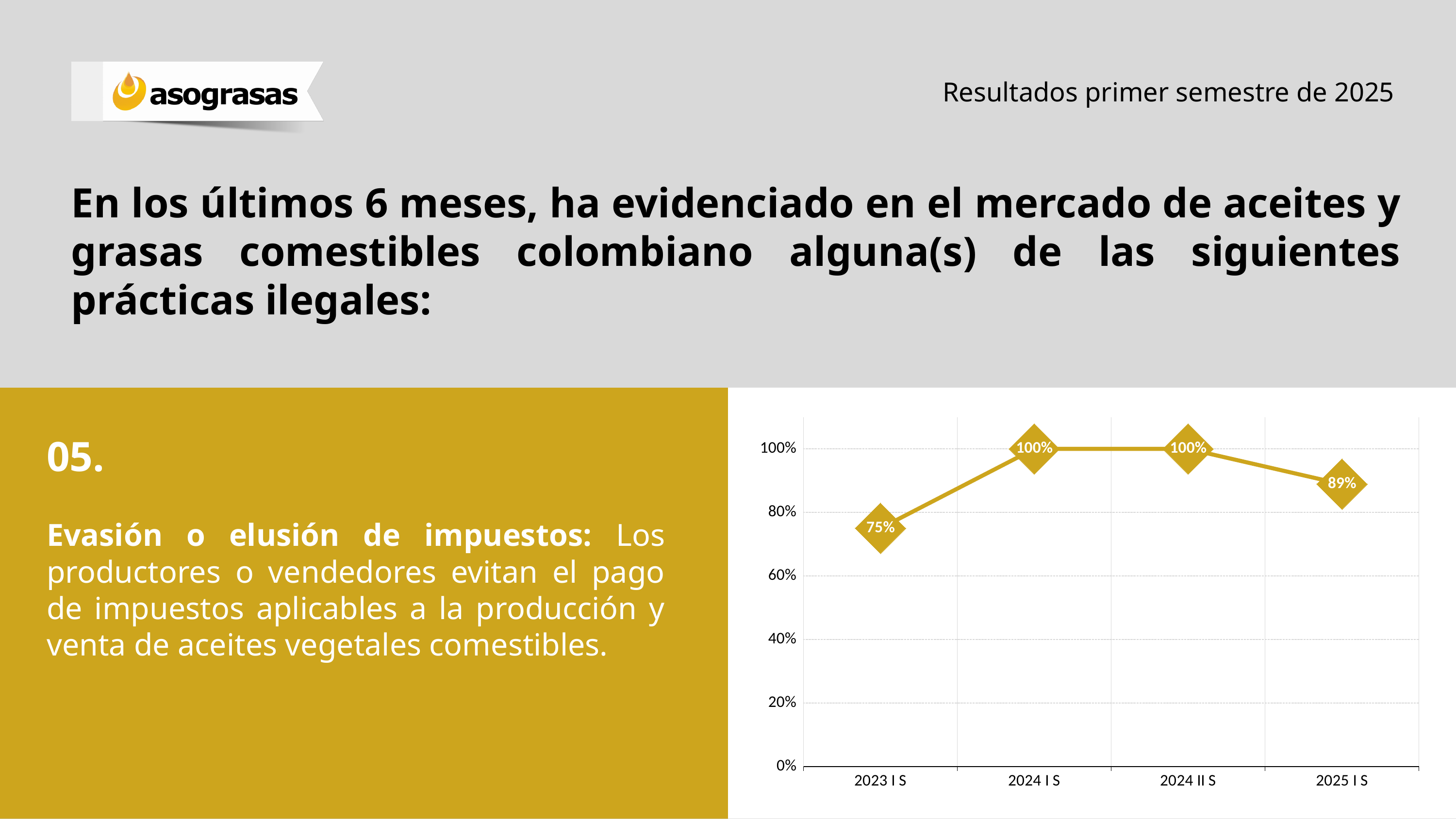
How many periods are plotted on the x axis? 4 What is the difference between the values for 2024 I S and 2023 I S? 25% Does the value rise or fall from 2024 II S to 2025 I S? fall What shape are the data point markers on the line? diamonds What is the value for 2024 II S? 100% Which period has the lowest value? 2023 I S What is the difference between the values for 2024 II S and 2025 I S? 11% Which is larger, the value for 2025 I S or the value for 2023 I S? 2025 I S Is the value for 2025 I S greater or less than 80%? greater What is the value for 2023 I S? 75% What kind of chart is shown on the slide? line chart What is the value for 2025 I S? 89%